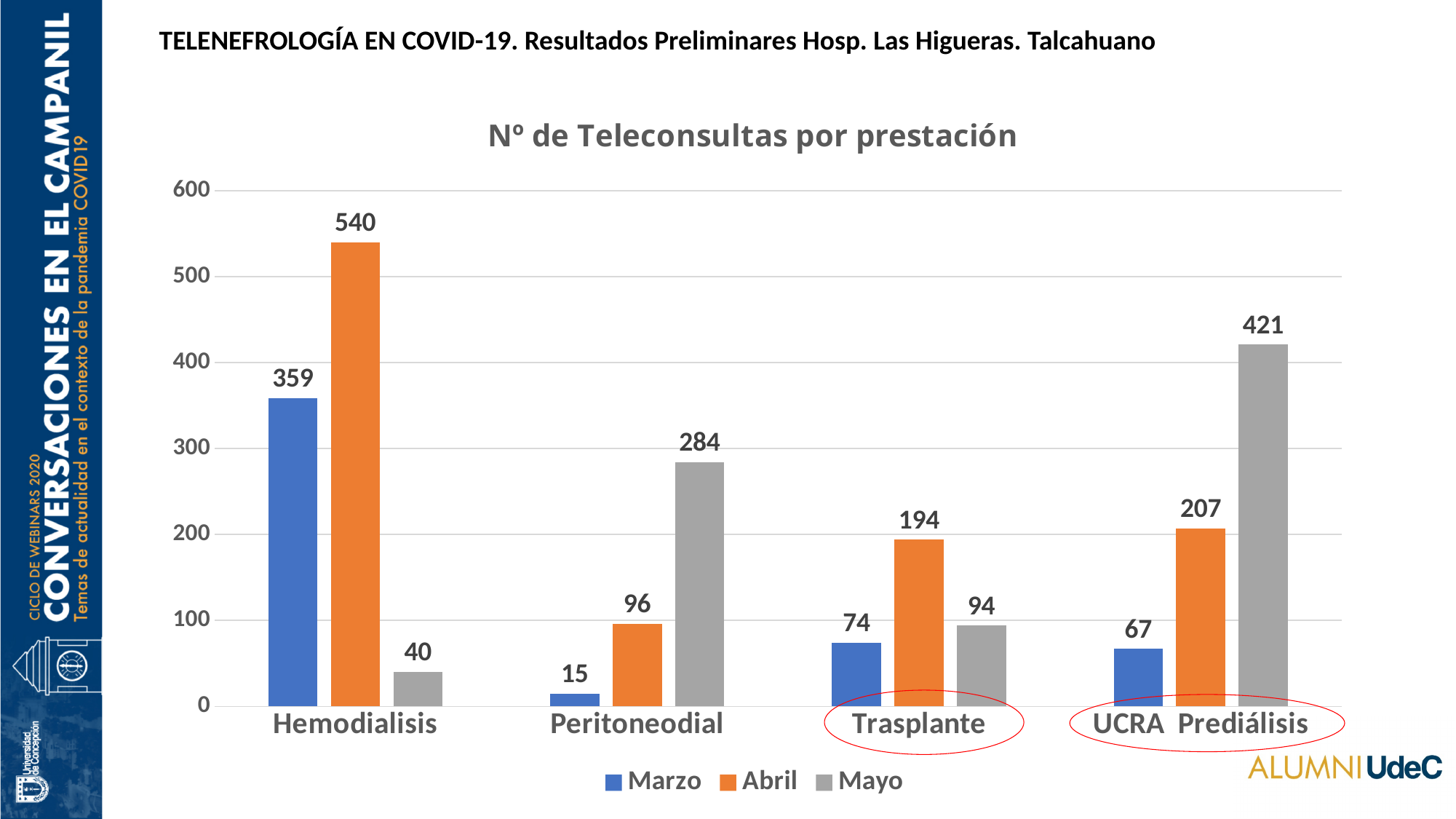
Which is larger: the Mayo value for Hemodialisis or the Mayo value for Trasplante? Mayo value for Trasplante What is the value for Abril in the Hemodialisis category? 540 Which category has the lowest Marzo value? Peritoneodial What is the title of the chart? Nº de Teleconsultas por prestación What is the value for Mayo in the Peritoneodial category? 284 Which colour represents the Mayo series in the legend? Grey How many categories are shown on the x axis? 4 What is the difference between the Abril and Marzo values for Trasplante? 120 How many series does the legend list? 3 What kind of chart is shown? Bar chart Which category has the highest Mayo value? UCRA Prediálisis What is the value for Marzo in the UCRA Prediálisis category? 67